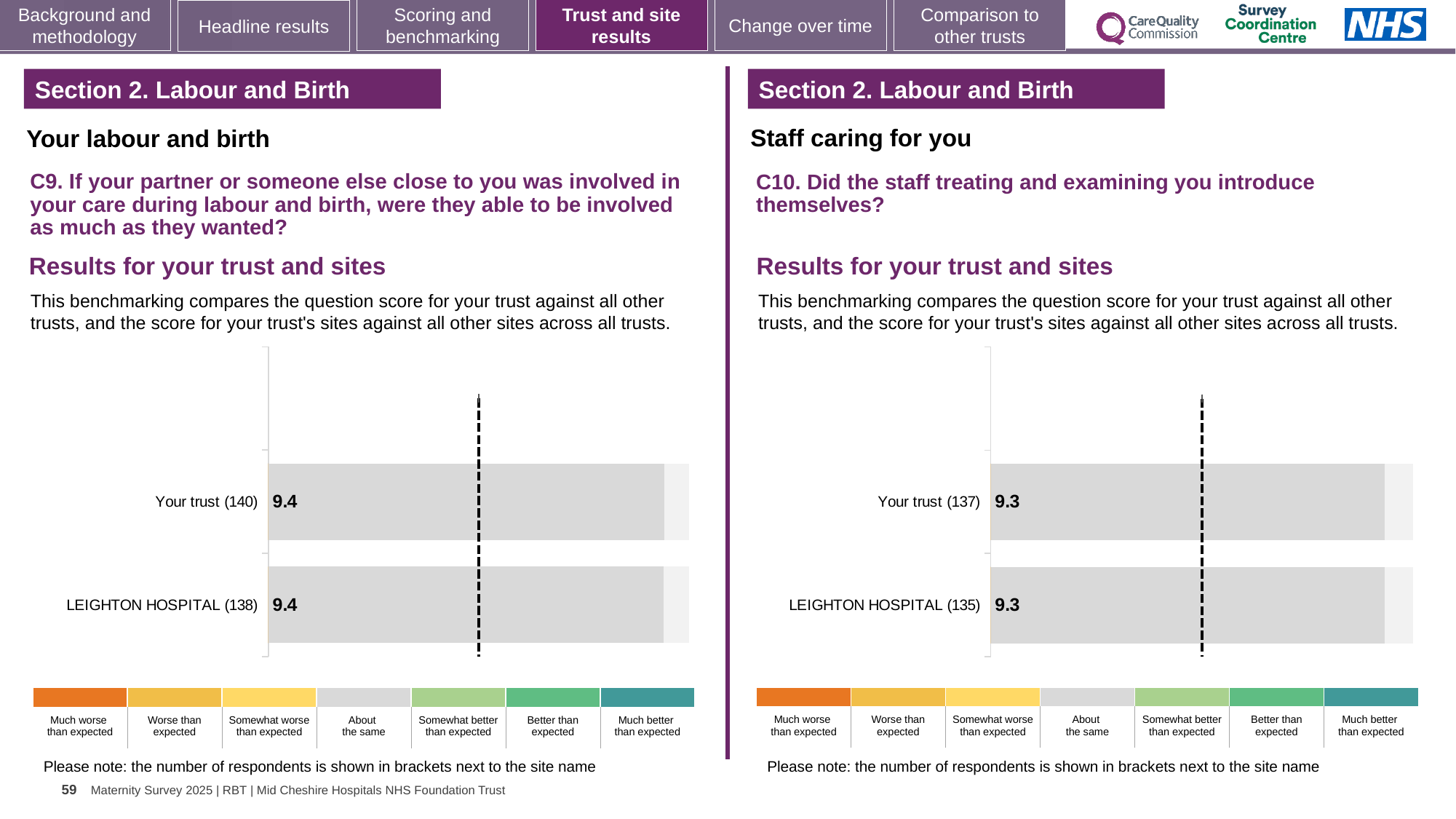
On the left chart (C9), what is the score for LEIGHTON HOSPITAL? 9.4 On the right chart (C10), what is the score for LEIGHTON HOSPITAL? 9.3 How many bars are plotted on the right chart (C10)? 2 How many bars are plotted on the left chart (C9)? 2 On the left chart (C9), what is the difference between the score for Your trust and the score for LEIGHTON HOSPITAL? 0 On the right chart (C10), what is the score for Your trust? 9.3 On the right chart (C10), how many respondents are shown in brackets for LEIGHTON HOSPITAL? 135 What kind of chart is used on the left (C9)? Bar chart On the left chart (C9), what is the score for Your trust? 9.4 On the left chart (C9), how many respondents are shown in brackets for Your trust? 140 On the right chart (C10), what is the difference between the score for Your trust and the score for LEIGHTON HOSPITAL? 0 Is the score for Your trust on the right chart (C10) larger or smaller than the score for Your trust on the left chart (C9)? Smaller